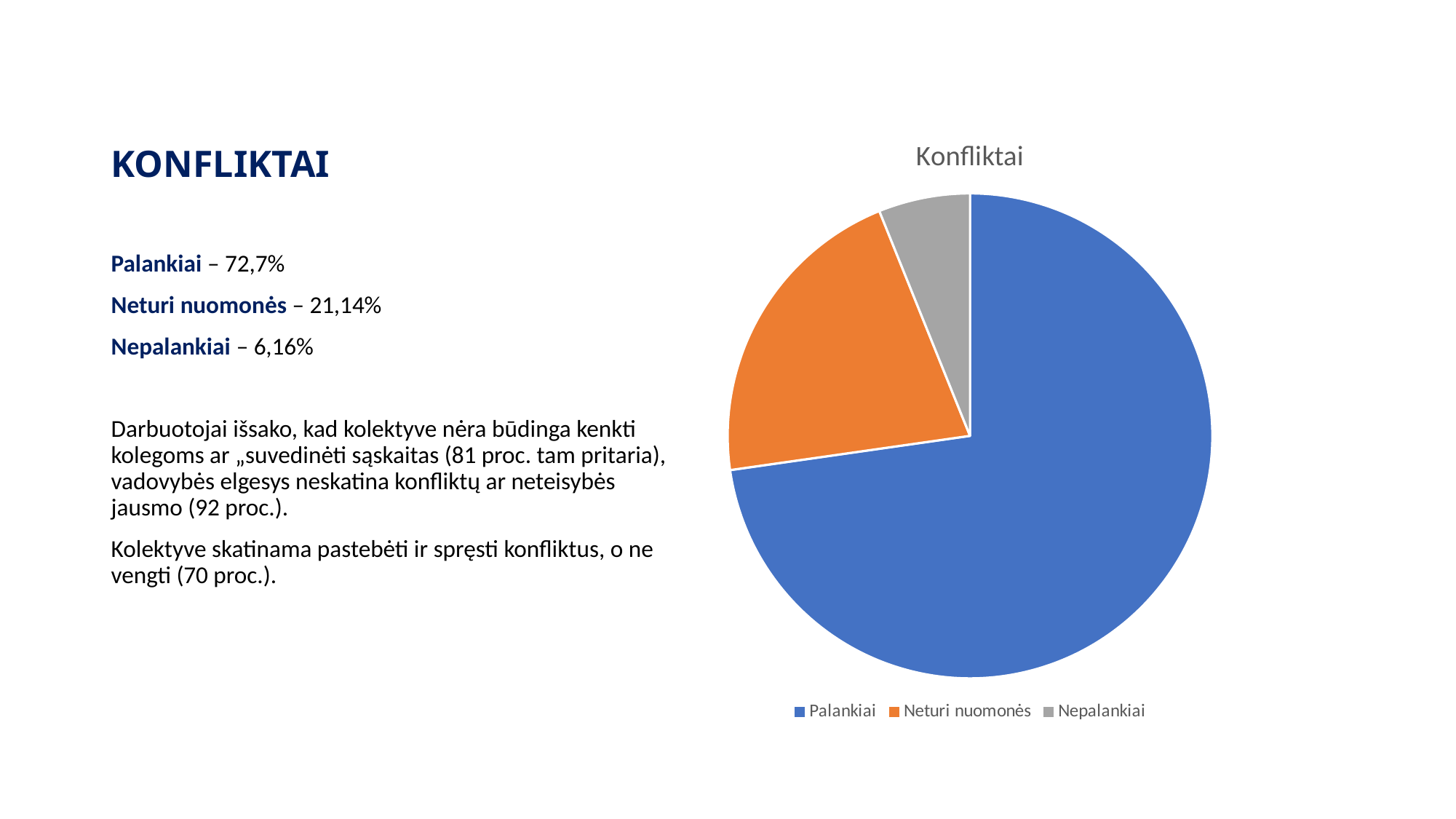
How many entries does the chart legend list? 3 What is the title of the chart? Konfliktai What share of the pie does Palankiai represent? 72,7% Which category has the largest slice of the pie? Palankiai What kind of chart is shown on the slide? pie chart Which category has the smallest slice of the pie? Nepalankiai What share of the pie does Nepalankiai represent? 6,16% Is the share for Palankiai greater or less than 50%? greater What colour is the Neturi nuomonės slice in the pie chart? orange What share of the pie does Neturi nuomonės represent? 21,14% How many slices does the pie chart have? 3 Which slice is larger, Neturi nuomonės or Nepalankiai? Neturi nuomonės